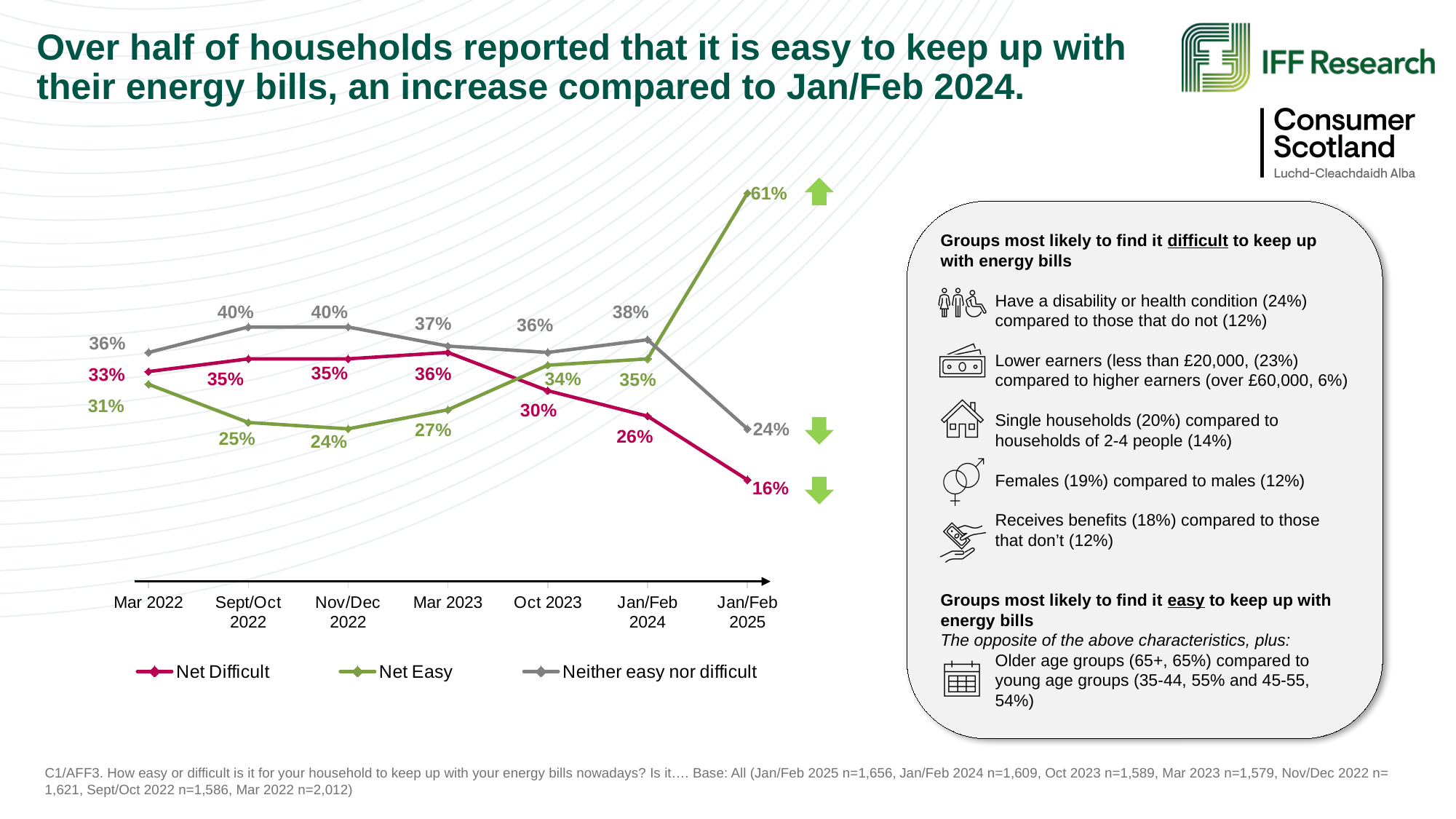
In which period is the Net Easy value highest? Jan/Feb 2025 What is the Net Easy value for Jan/Feb 2025? 61% What is the value for Neither easy nor difficult in Sept/Oct 2022? 40% In Mar 2022, which is larger: Net Difficult or Net Easy? Net Difficult By how many percentage points did Net Easy increase from Jan/Feb 2024 to Jan/Feb 2025? 26 percentage points In which period is the Net Difficult value lowest? Jan/Feb 2025 How many series does the legend list? 3 How many time periods are plotted on the x axis? 7 What kind of chart is shown on the slide? Line chart What is the Net Difficult value for Jan/Feb 2025? 16% What is the Net Easy value for Nov/Dec 2022? 24% In which period is the Net Easy value lowest? Nov/Dec 2022